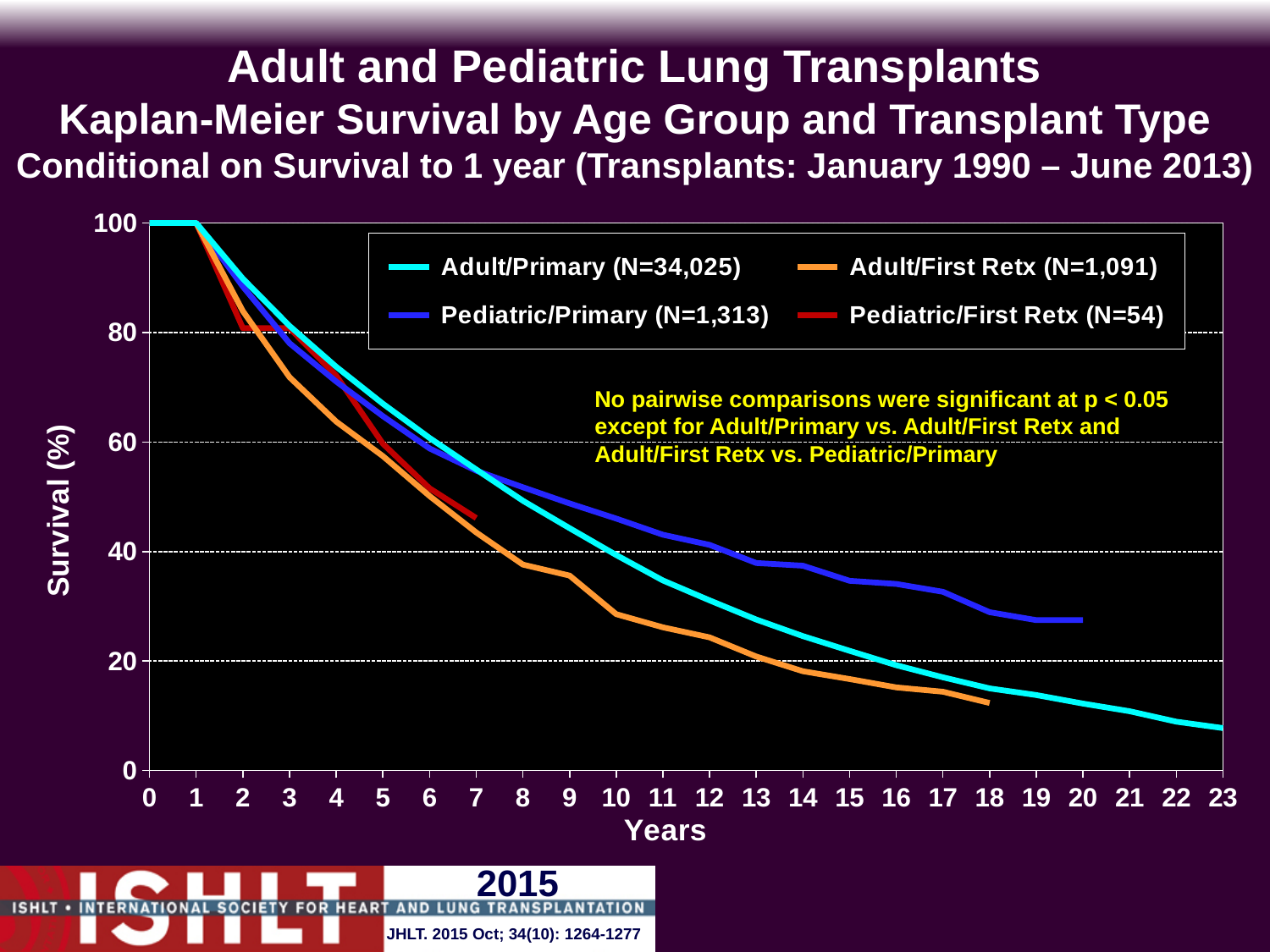
How many series does the legend list? 4 What is the N shown in the legend for Adult/Primary? N=34,025 At year 15, which series has higher survival: Pediatric/Primary or Adult/Primary? Pediatric/Primary Is the survival value for Adult/First Retx at year 18 greater or less than 20? less At year 3, which series has higher survival: Adult/Primary or Adult/First Retx? Adult/Primary What is the survival value for all series at year 0? 100 Is the survival value for Pediatric/Primary at year 20 greater or less than 20? greater Do the survival curves rise or fall as years increase? fall Is the survival value for Adult/First Retx at year 10 greater or less than 40? less Which series has the highest survival at year 15? Pediatric/Primary What kind of chart is shown on the slide? line chart